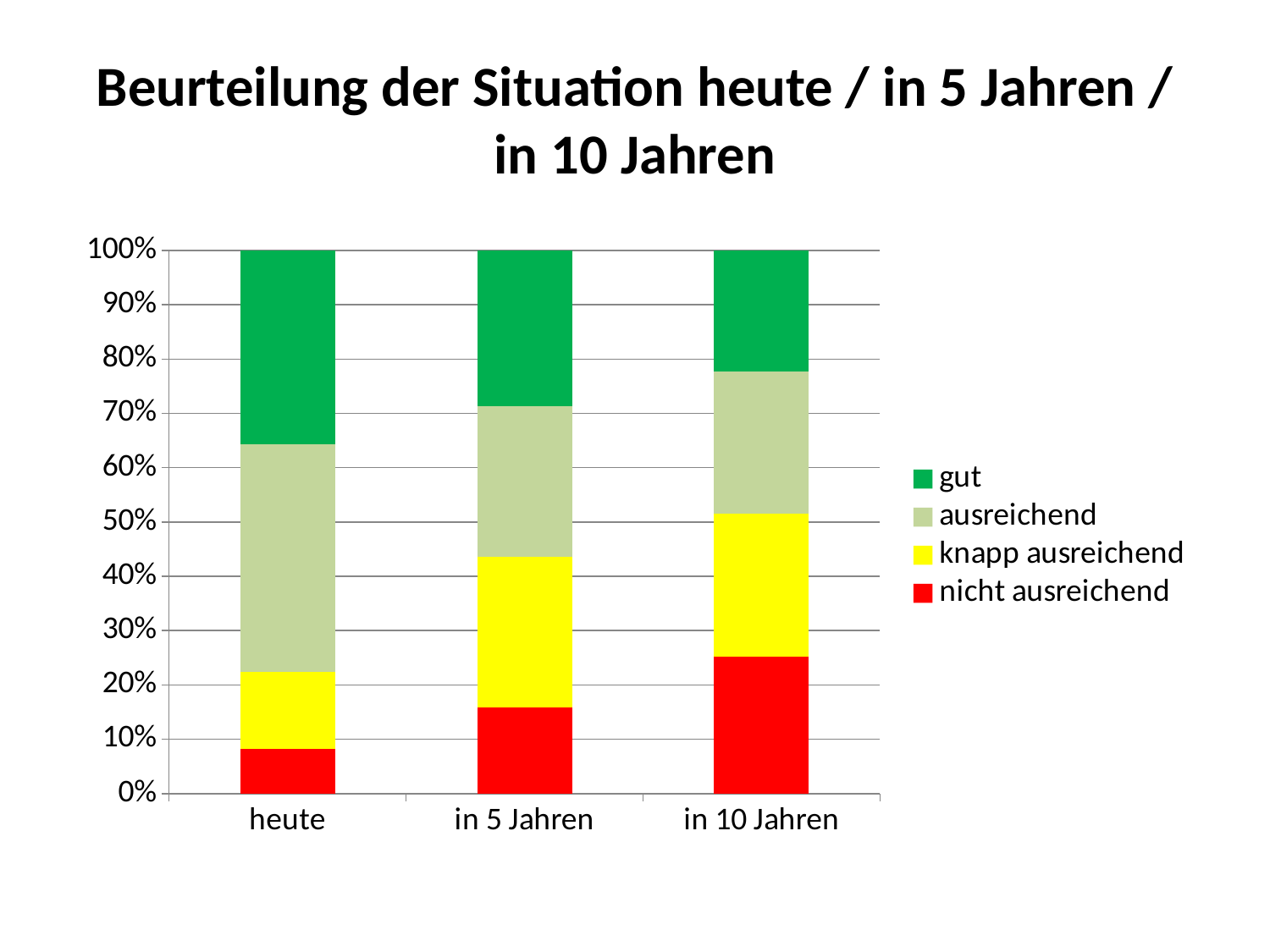
Which category has the largest "nicht ausreichend" segment? in 10 Jahren Is the value for "nicht ausreichend" in the "in 10 Jahren" bar greater or less than 20%? greater Which category has the smallest "gut" segment? in 10 Jahren What is the title of the chart? Beurteilung der Situation heute / in 5 Jahren / in 10 Jahren Which colour represents the series "nicht ausreichend" in the legend? red How many categories are shown on the x axis? 3 Is the value for "nicht ausreichend" in the "heute" bar greater or less than 10%? less How many series does the legend list? 4 What kind of chart is shown on the slide? bar chart Which is larger: the "nicht ausreichend" segment for "heute" or for "in 10 Jahren"? in 10 Jahren What is the total height of the stacked bar for "heute"? 100% Does the "nicht ausreichend" segment rise or fall from "heute" to "in 10 Jahren"? rise